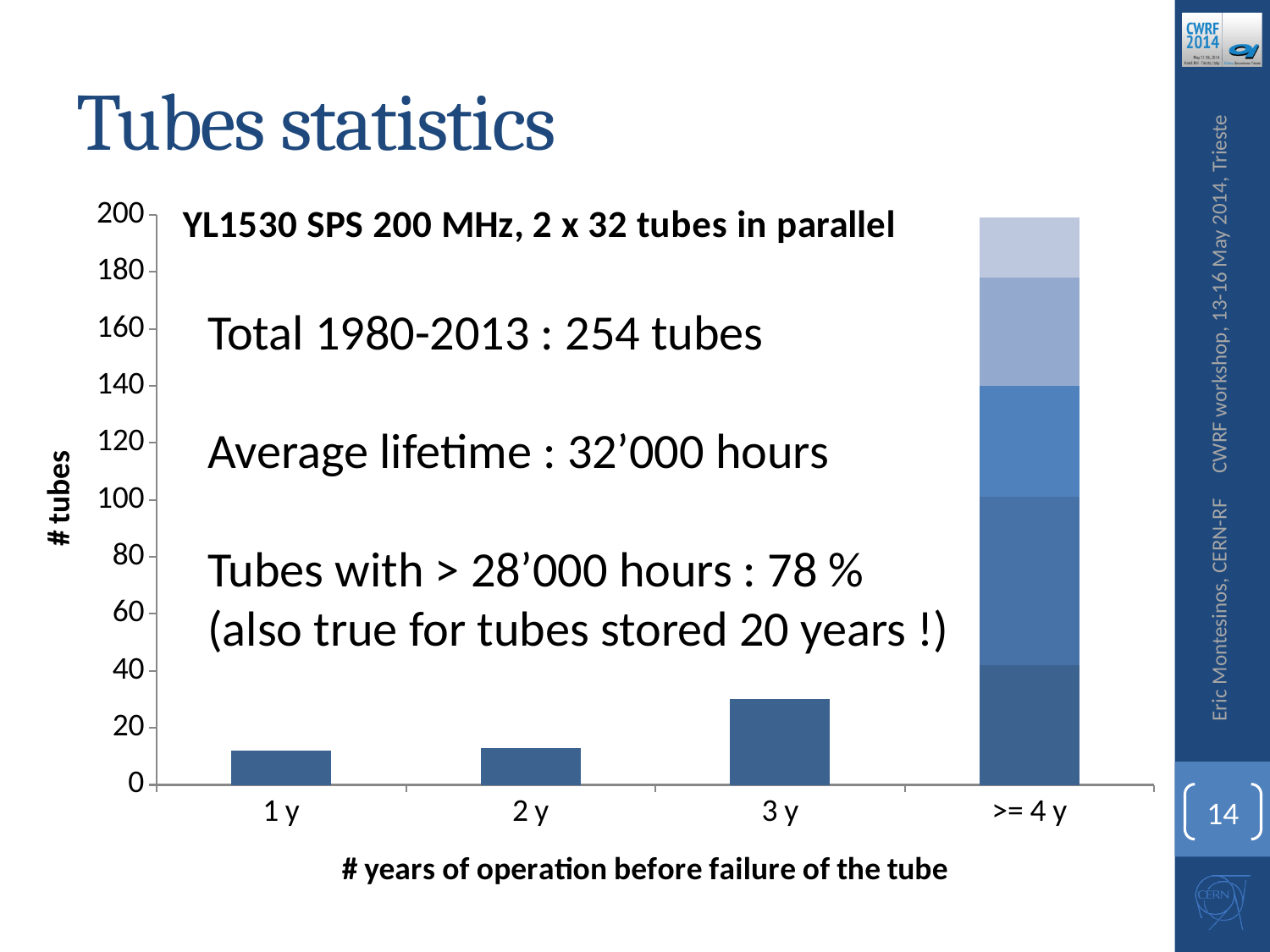
What is the title of the chart? YL1530 SPS 200 MHz, 2 x 32 tubes in parallel Do the bar heights rise or fall from 1 y to >= 4 y along the x axis? rise Is the value for 3 y greater or less than 40? less Is the value for 3 y greater or less than 20? greater Is the value for 2 y greater or less than 20? less How many categories are shown on the x axis of the chart? 4 Which is larger, the value for 3 y or the value for 1 y? 3 y What kind of chart is shown on the slide? bar chart Which category has the highest bar in the chart? >= 4 y What is the label of the x axis of the chart? # years of operation before failure of the tube